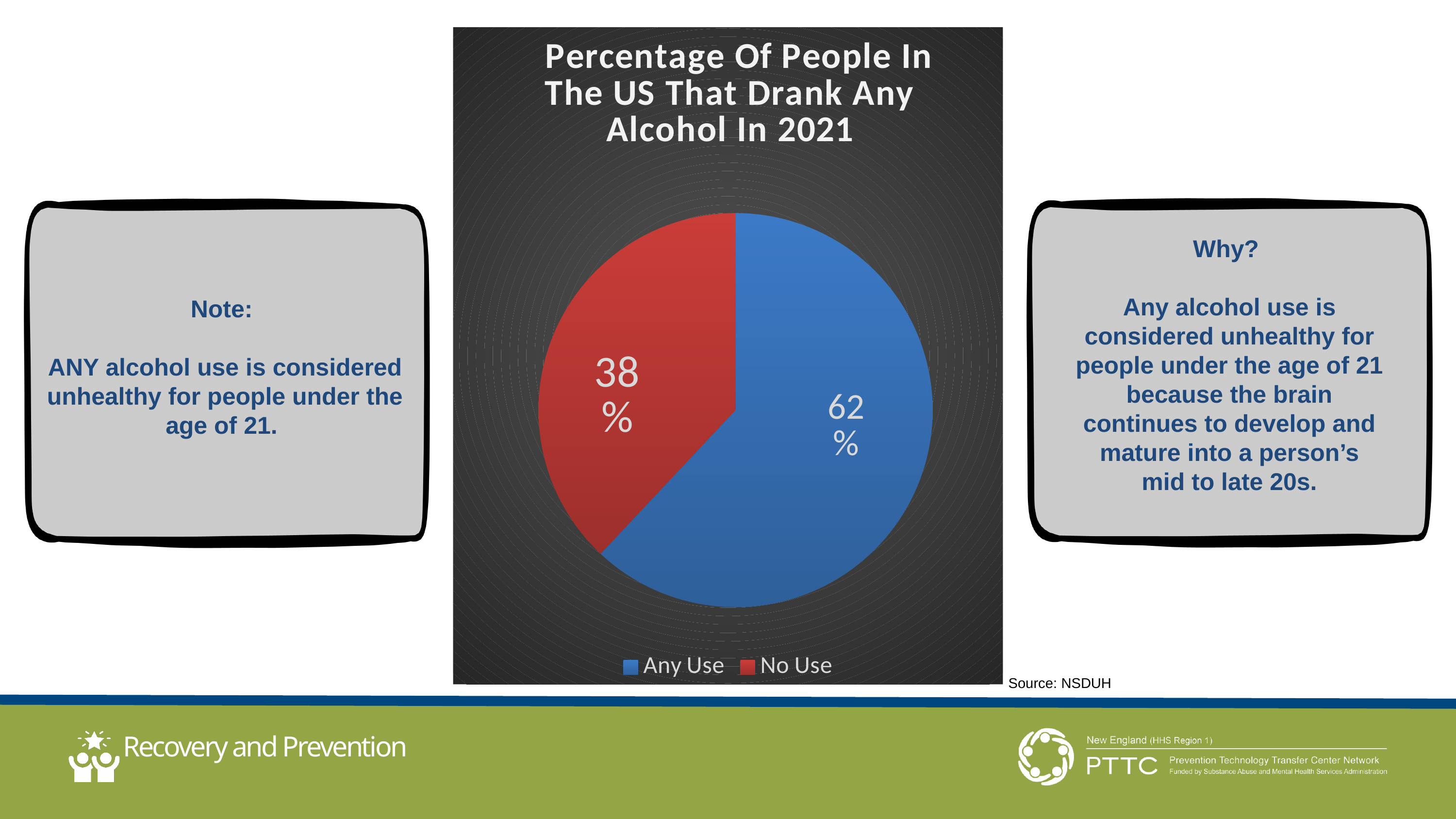
What percentage of the pie is labelled "Any Use"? 62% Which is larger, the "Any Use" slice or the "No Use" slice? Any Use What colour is the "No Use" slice? red How many slices does the pie chart have? 2 How many entries does the legend list? 2 Which slice is the largest in the pie chart? Any Use What share of the pie does the "Any Use" slice represent? 62% What type of chart is shown on the slide? pie chart What is the difference in percentage points between the "Any Use" and "No Use" slices? 24 Which slice is the smallest in the pie chart? No Use What is the title of the chart? Percentage Of People In The US That Drank Any Alcohol In 2021 What percentage of the pie is labelled "No Use"? 38%